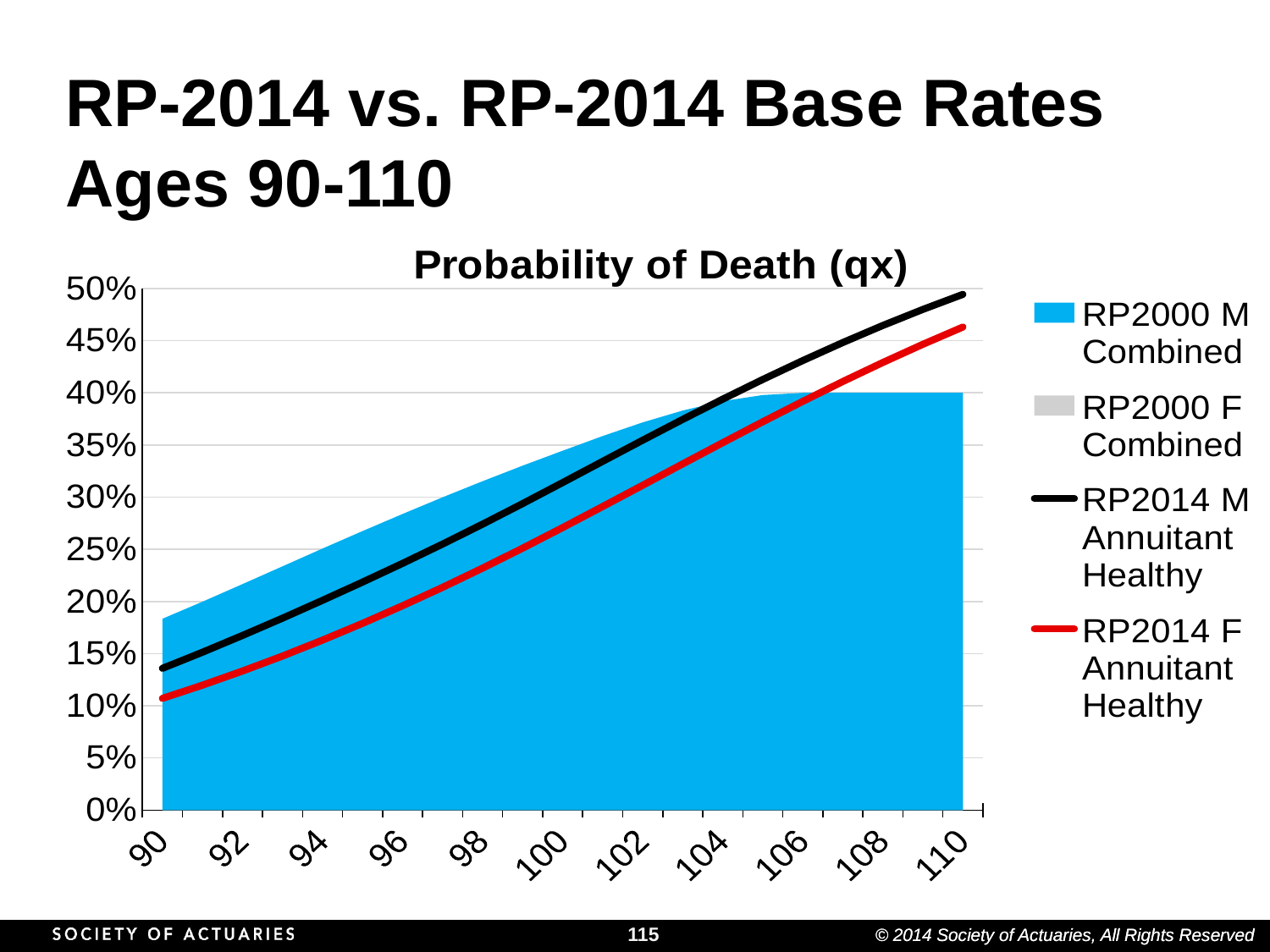
What colour is the RP2014 F Annuitant Healthy line? Red Is the value for RP2014 M Annuitant Healthy at age 110 greater or less than 45%? greater At age 110, which is higher: RP2014 M Annuitant Healthy or RP2014 F Annuitant Healthy? RP2014 M Annuitant Healthy At age 90, which is higher: RP2000 M Combined or RP2014 M Annuitant Healthy? RP2000 M Combined Is the value for RP2014 F Annuitant Healthy at age 90 greater or less than 10%? greater What value does the RP2000 M Combined series level off at by age 110? 40% Does the RP2014 M Annuitant Healthy line rise or fall as age increases from 90 to 110? Rises How many age labels are shown on the x axis? 11 Is the value for RP2014 M Annuitant Healthy at age 90 greater or less than 15%? less How many series does the legend list? 4 What is the title of the chart? Probability of Death (qx)